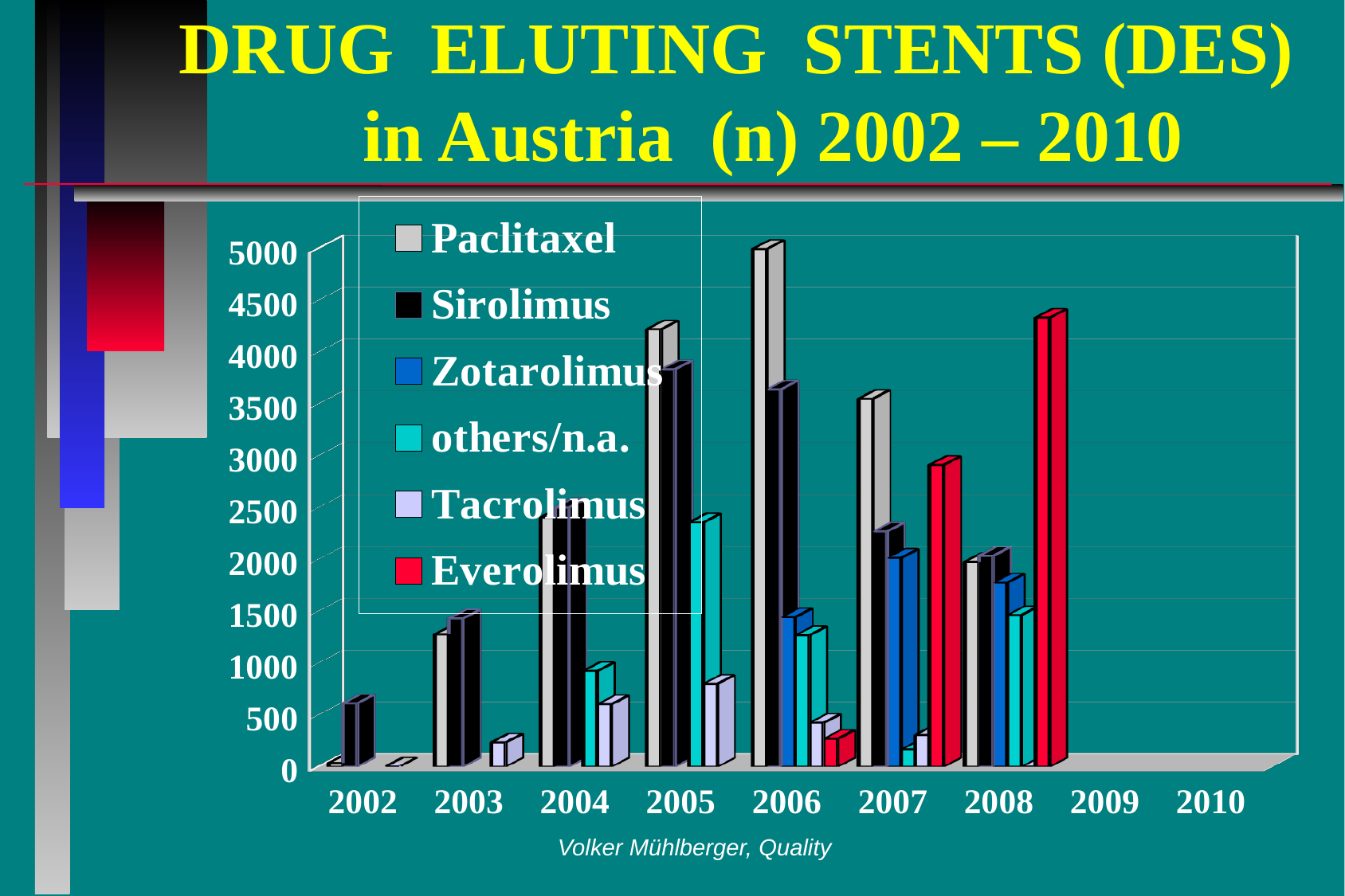
How many series does the legend list? 6 In which year is the Everolimus bar the tallest? 2008 In 2007, which is larger: Everolimus or Sirolimus? Everolimus Is the value for Paclitaxel in 2006 greater or less than 4500? greater Which colour represents Everolimus in the legend? red How many years are shown on the x axis? 9 Do the Everolimus values rise or fall from 2006 to 2008? rise What kind of chart is shown on the slide? bar chart In 2006, which is larger: Paclitaxel or Sirolimus? Paclitaxel Is the value for Sirolimus in 2005 greater or less than 3500? greater Is the value for Everolimus in 2008 greater or less than 4000? greater In which year is the Paclitaxel bar the tallest? 2006